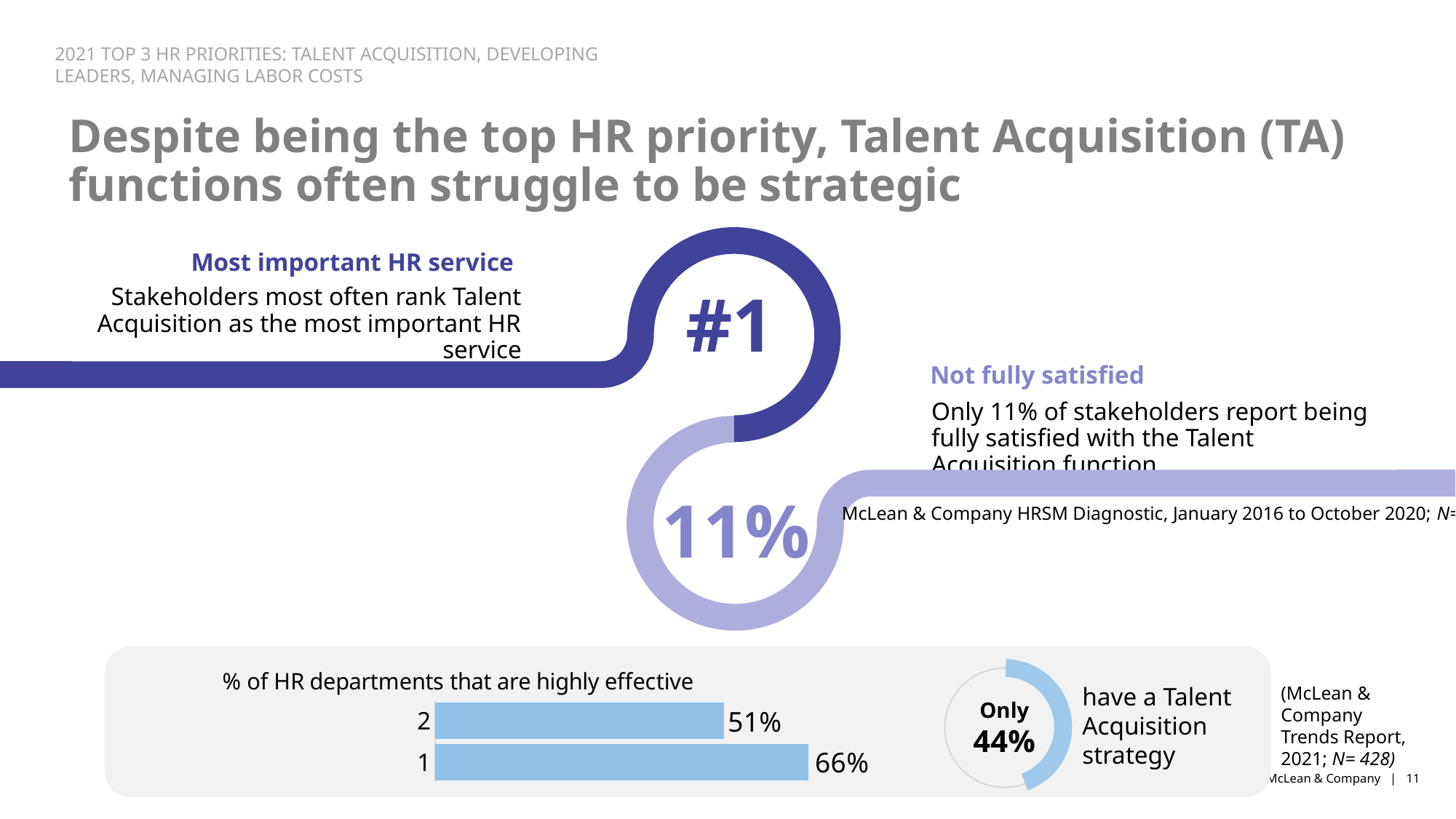
In the bar chart titled '% of HR departments that are highly effective', what is the value for category 2? 51% What colour are the bars in the bar chart at the bottom of the slide? Light blue In the bar chart at the bottom of the slide, what is the difference between the values for category 1 and category 2? 15% What is the title of the bar chart at the bottom of the slide? % of HR departments that are highly effective In the bar chart at the bottom of the slide, which category has the highest value? 1 How many categories are shown in the bar chart at the bottom of the slide? 2 What percentage is shown in the ring graphic to the right of the bar chart, next to 'have a Talent Acquisition strategy'? 44% In the bar chart at the bottom of the slide, which is larger: the value for category 1 or category 2? 1 What kind of chart is shown at the bottom left of the slide? Bar chart What percentage is shown in the large light purple ring graphic in the middle of the slide? 11% In the bar chart at the bottom of the slide, which category has the lowest value? 2 In the bar chart titled '% of HR departments that are highly effective', what is the value for category 1? 66%